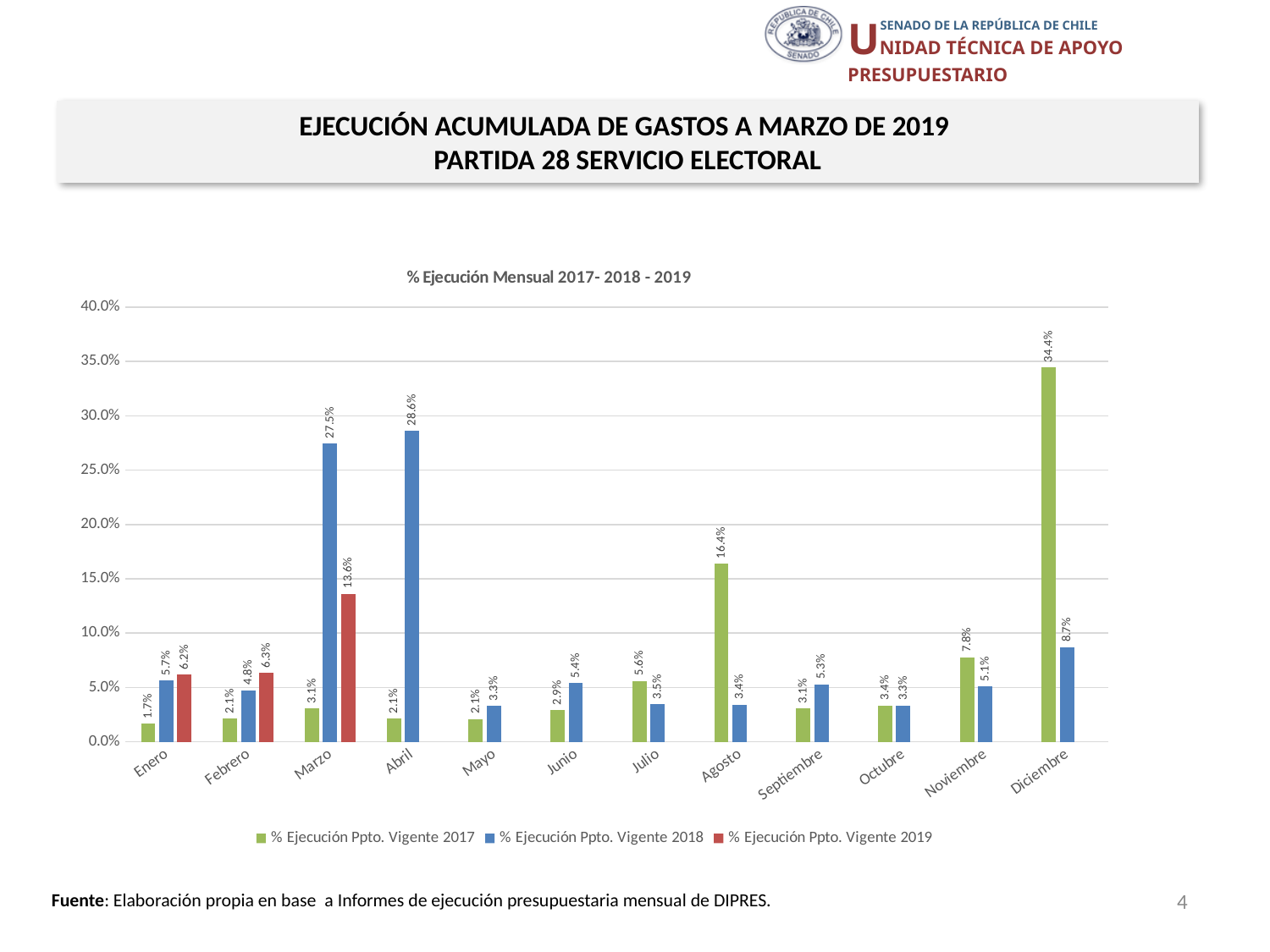
How many series does the legend list? 3 What is the value for Marzo in the % Ejecución Ppto. Vigente 2019 series? 13.6% Which month has the highest value in the % Ejecución Ppto. Vigente 2018 series? Abril What is the difference between the 2018 and 2019 values for Marzo? 13.9% What kind of chart is shown on the slide? Bar chart How many months are shown on the x axis? 12 Which month has the highest value in the % Ejecución Ppto. Vigente 2017 series? Diciembre What is the title of the chart? % Ejecución Mensual 2017- 2018 - 2019 What is the value for Abril in the % Ejecución Ppto. Vigente 2018 series? 28.6% Which is larger for Enero: the 2018 value or the 2019 value? 2019 value (6.2%) What is the value for Agosto in the % Ejecución Ppto. Vigente 2017 series? 16.4% Which month has the lowest value in the % Ejecución Ppto. Vigente 2017 series? Enero